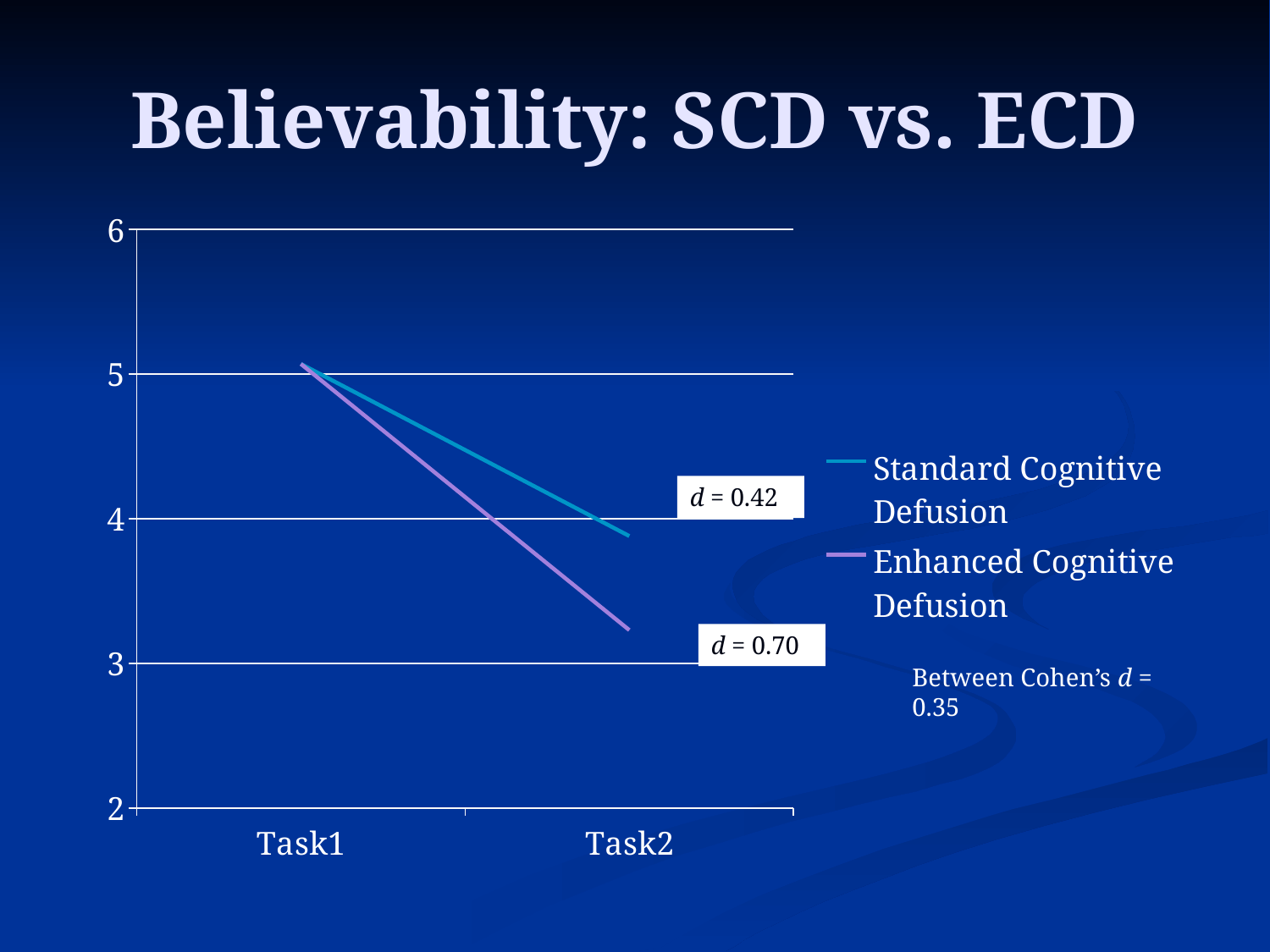
What is the title of the slide? Believability: SCD vs. ECD Do the values for Standard Cognitive Defusion rise or fall from Task1 to Task2? fall What kind of chart is shown on the slide? line chart What Cohen's d value is annotated next to the Enhanced Cognitive Defusion line? d = 0.70 Is the value for Standard Cognitive Defusion at Task1 greater or less than 4? greater How many categories are shown on the x axis? 2 How many series does the legend list? 2 Which series has the lowest value at Task2? Enhanced Cognitive Defusion Is the value for Enhanced Cognitive Defusion at Task2 greater or less than 4? less At Task2, which series has the higher value, Standard Cognitive Defusion or Enhanced Cognitive Defusion? Standard Cognitive Defusion Do the values for Enhanced Cognitive Defusion rise or fall from Task1 to Task2? fall Is the value for Enhanced Cognitive Defusion at Task2 greater or less than 3? greater